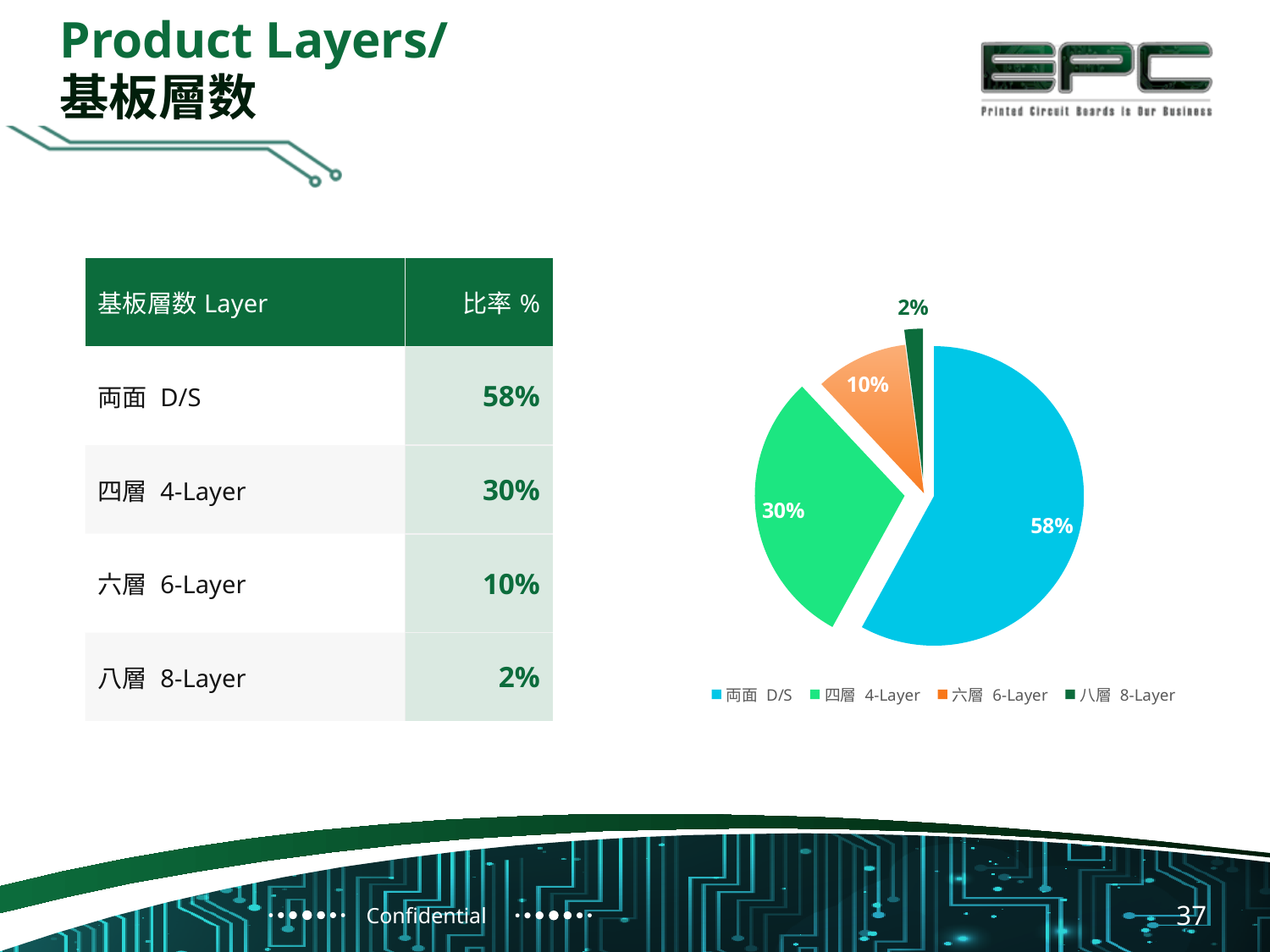
What colour is the 四層 4-Layer slice in the pie chart? green What is the difference in percentage points between the 両面 D/S slice and the 四層 4-Layer slice? 28% What kind of chart is shown on the slide? pie chart What share of the pie does 八層 8-Layer have? 2% How many slices does the pie chart have? 4 What share of the pie does 両面 D/S (double-sided) have? 58% Which category has the smallest slice of the pie? 八層 8-Layer How many entries does the legend list? 4 Which is larger, the 六層 6-Layer slice or the 八層 8-Layer slice? 六層 6-Layer What share of the pie does 四層 4-Layer have? 30% What share of the pie does 六層 6-Layer have? 10% Which category has the largest slice of the pie? 両面 D/S